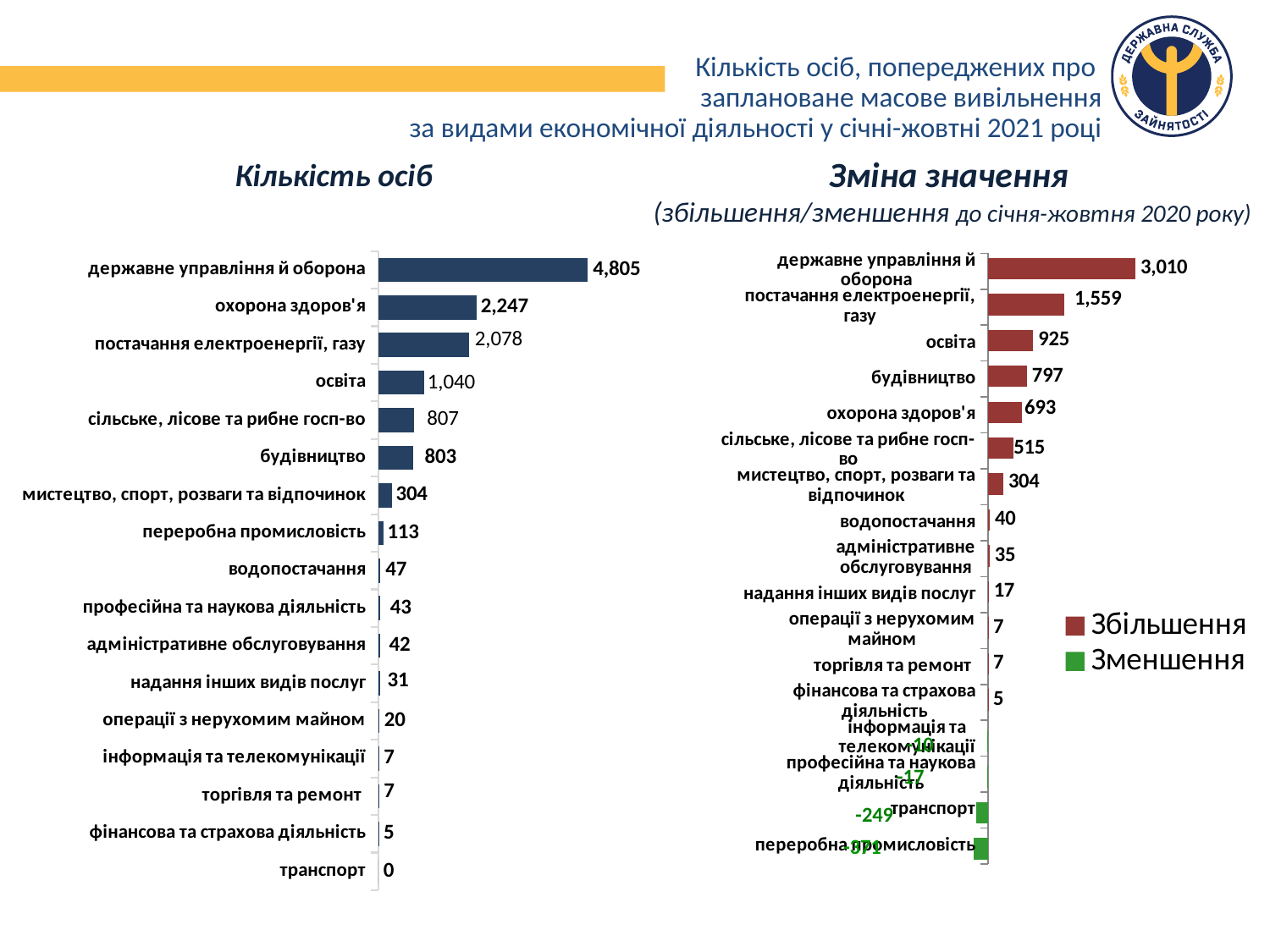
What type of chart is the 'Кількість осіб' chart? bar chart In the 'Кількість осіб' chart, which category has the highest value? державне управління й оборона In the 'Зміна значення' chart, which category has the highest value? державне управління й оборона In the 'Зміна значення' chart, what is the value for будівництво? 797 How many series does the legend of the 'Зміна значення' chart list? 2 In the 'Кількість осіб' chart, how many categories are shown? 17 In the 'Кількість осіб' chart, what is the value for державне управління й оборона? 4,805 In the 'Кількість осіб' chart, what is the difference between охорона здоров'я and постачання електроенергії, газу? 169 In the 'Кількість осіб' chart, what is the value for освіта? 1,040 In the 'Зміна значення' chart, what is the value for транспорт? -249 In the 'Кількість осіб' chart, which category has the lowest value? транспорт In the 'Зміна значення' chart, which is larger: освіта or охорона здоров'я? освіта